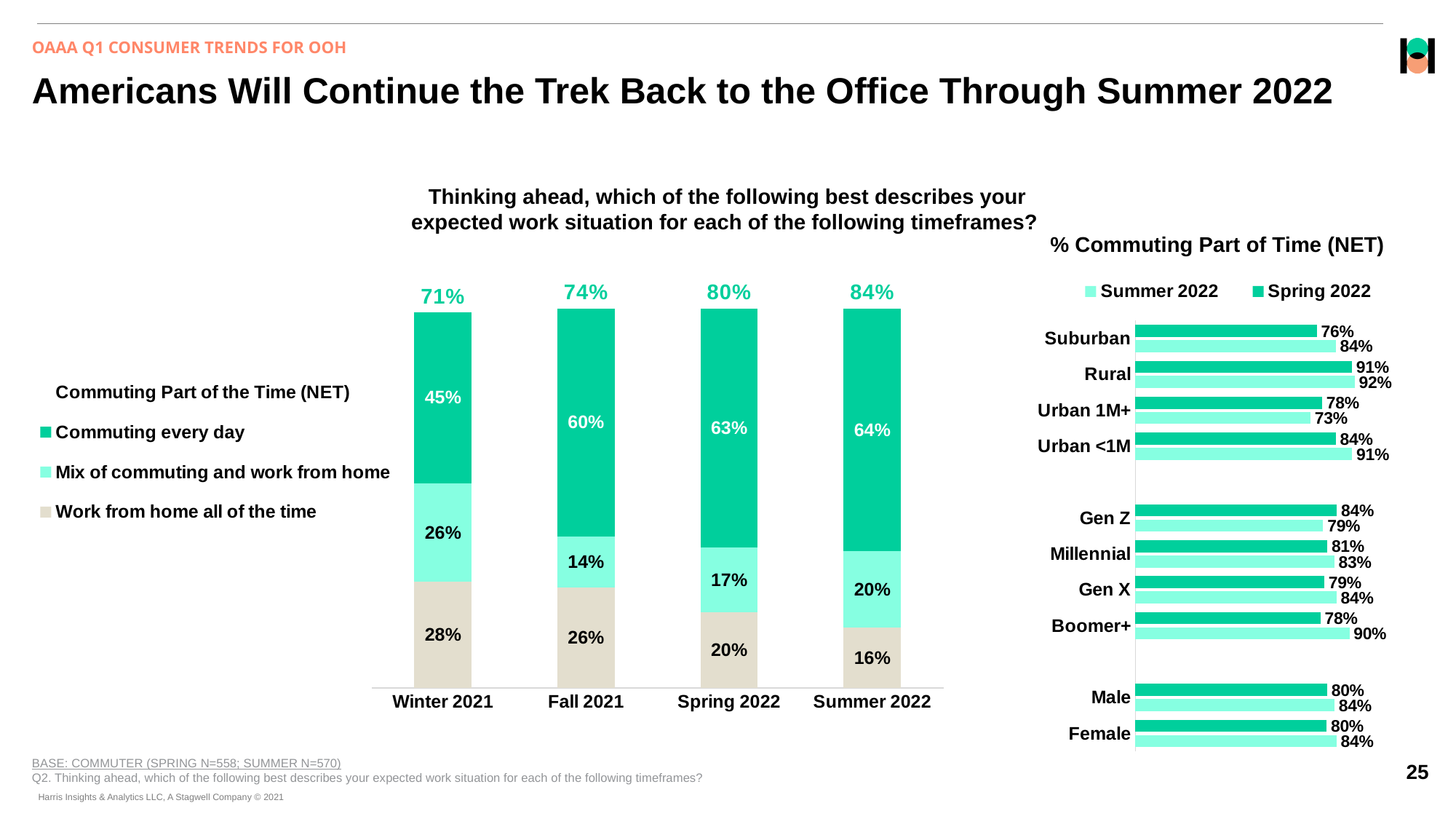
In the stacked bar chart on the left, what percentage of commuters expect to be commuting every day in Summer 2022? 64% In the '% Commuting Part of Time (NET)' chart, is the Summer 2022 value for Urban 1M+ larger or smaller than its Spring 2022 value? Smaller In the stacked bar chart on the left, which timeframe has the lowest share for 'Work from home all of the time'? Summer 2022 In the '% Commuting Part of Time (NET)' chart, which group has the highest Spring 2022 value? Rural In the stacked bar chart on the left, what is the difference between the 'Commuting every day' values for Fall 2021 and Winter 2021? 15% In the '% Commuting Part of Time (NET)' chart, what is the Summer 2022 value for Boomer+? 90% In the '% Commuting Part of Time (NET)' chart, what is the difference between the Summer 2022 and Spring 2022 values for Suburban? 8% In the stacked bar chart on the left, what is the Commuting Part of the Time (NET) value for Winter 2021? 71% What type of chart is the '% Commuting Part of Time (NET)' chart on the right? Bar chart In the stacked bar chart on the left, how does the Commuting Part of the Time (NET) value change from Winter 2021 to Summer 2022? It rises In the stacked bar chart on the left, what percentage expect to work from home all of the time in Fall 2021? 26%